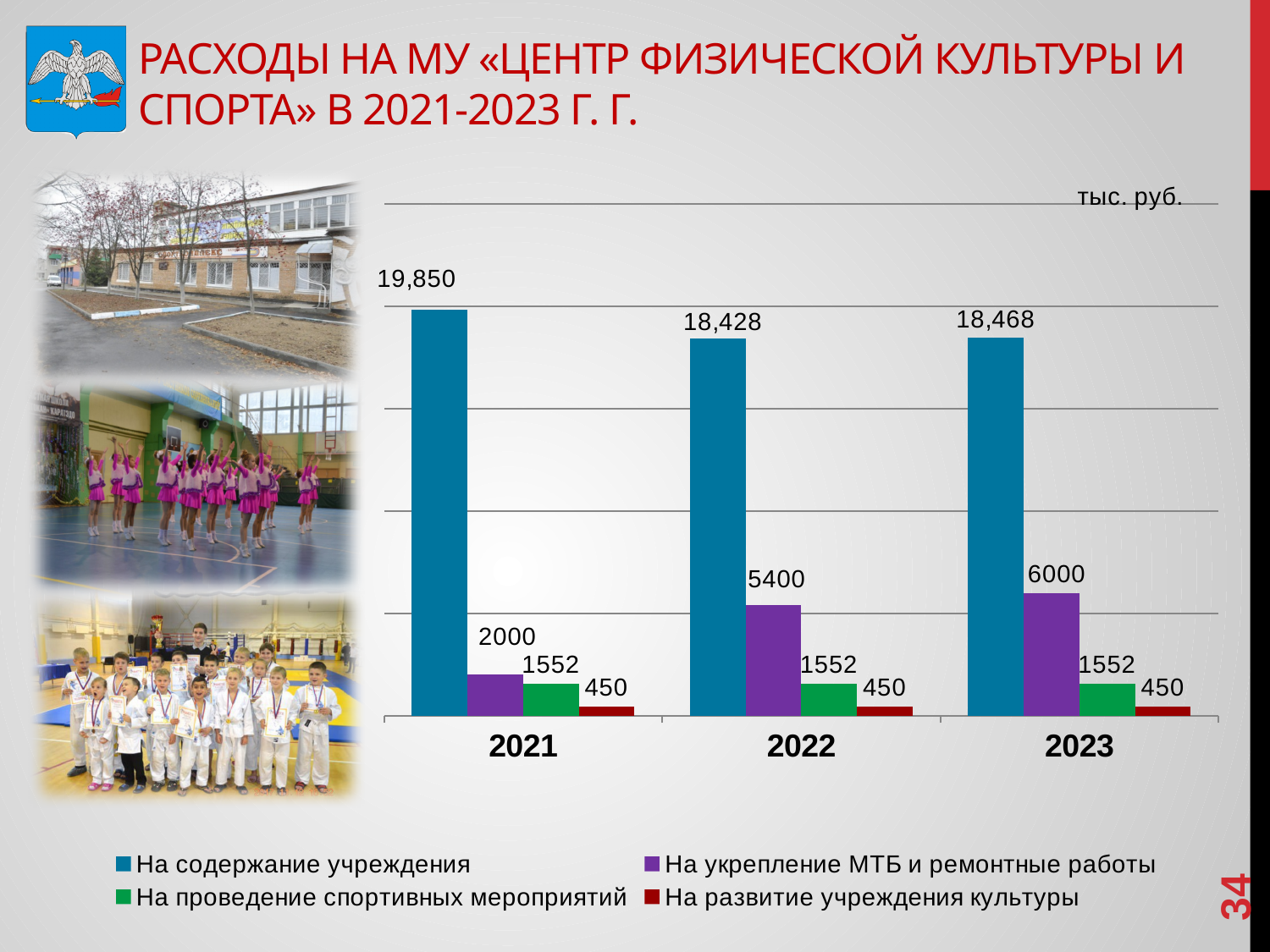
What is the value for «На содержание учреждения» in 2021? 19,850 Which is larger: the «На содержание учреждения» value for 2022 or for 2023? 2023 How many years are shown on the x axis? 3 How many series does the legend list? 4 What is the value for «На развитие учреждения культуры» in 2021? 450 What is the value for «На укрепление МТБ и ремонтные работы» in 2023? 6000 In which year is the value for «На содержание учреждения» highest? 2021 What is the difference between the «На укрепление МТБ и ремонтные работы» values for 2023 and 2022? 600 What kind of chart is shown on the slide? Bar chart What is the value for «На проведение спортивных мероприятий» in 2022? 1552 In which year is the value for «На укрепление МТБ и ремонтные работы» lowest? 2021 What unit is indicated above the chart? тыс. руб.